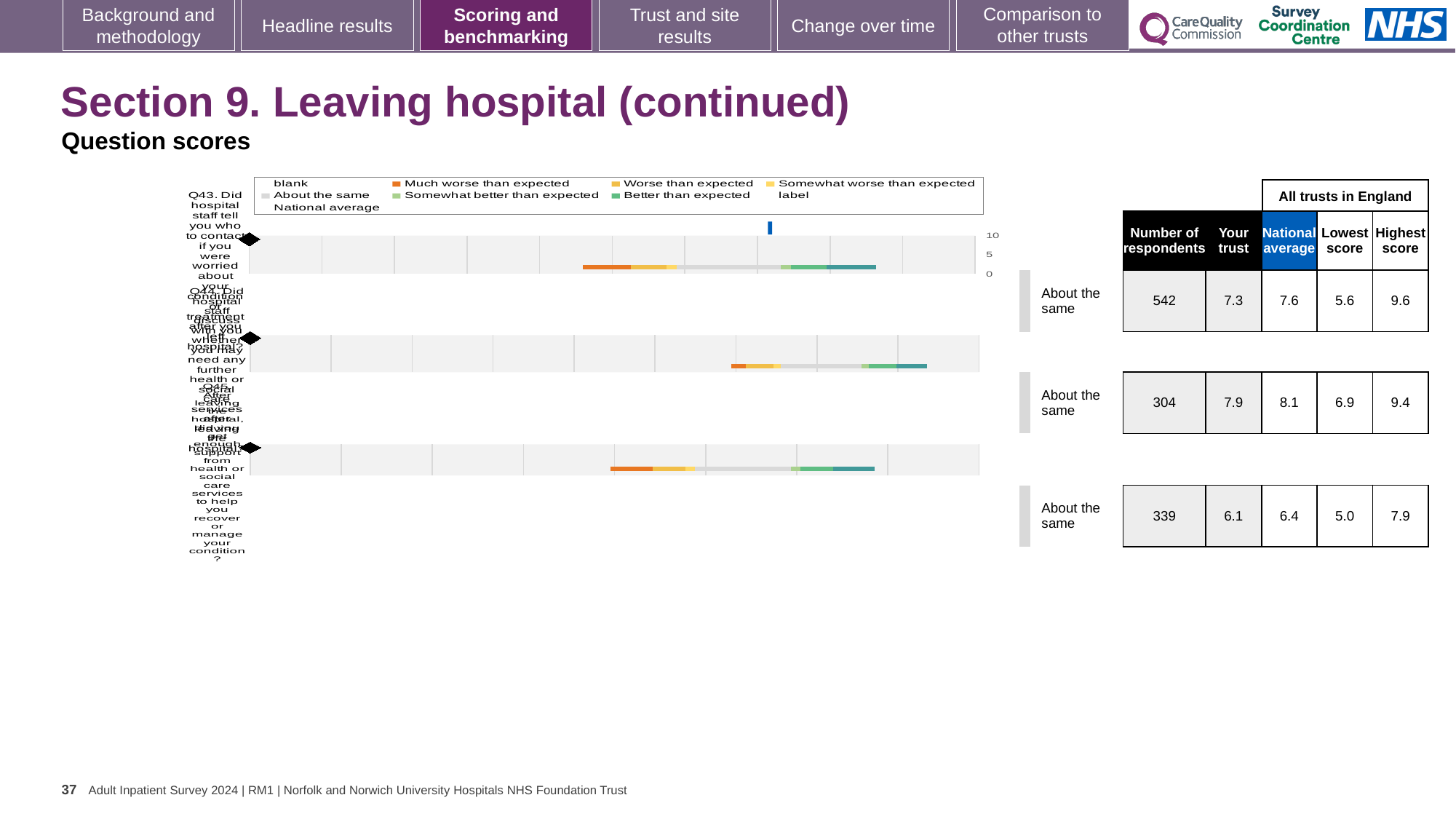
What is the 'Your trust' score for Q43? 7.3 For Q44, which is larger: the 'Your trust' score or the national average? National average What benchmark category is shown next to the Q43 row? About the same Which question has the highest 'Your trust' score? Q44 For Q43, what is the difference between the highest score and the lowest score among all trusts in England? 4.0 Which question has the lowest 'Your trust' score? Q45 For Q45, how much higher is the national average than the 'Your trust' score? 0.3 What is the lowest score among all trusts in England for Q45? 5.0 How many respondents are recorded for Q45? 339 How many questions (rows) are plotted in the chart? 3 What type of chart is used to show the question scores on this slide? bar chart What is the national average score for Q44? 8.1